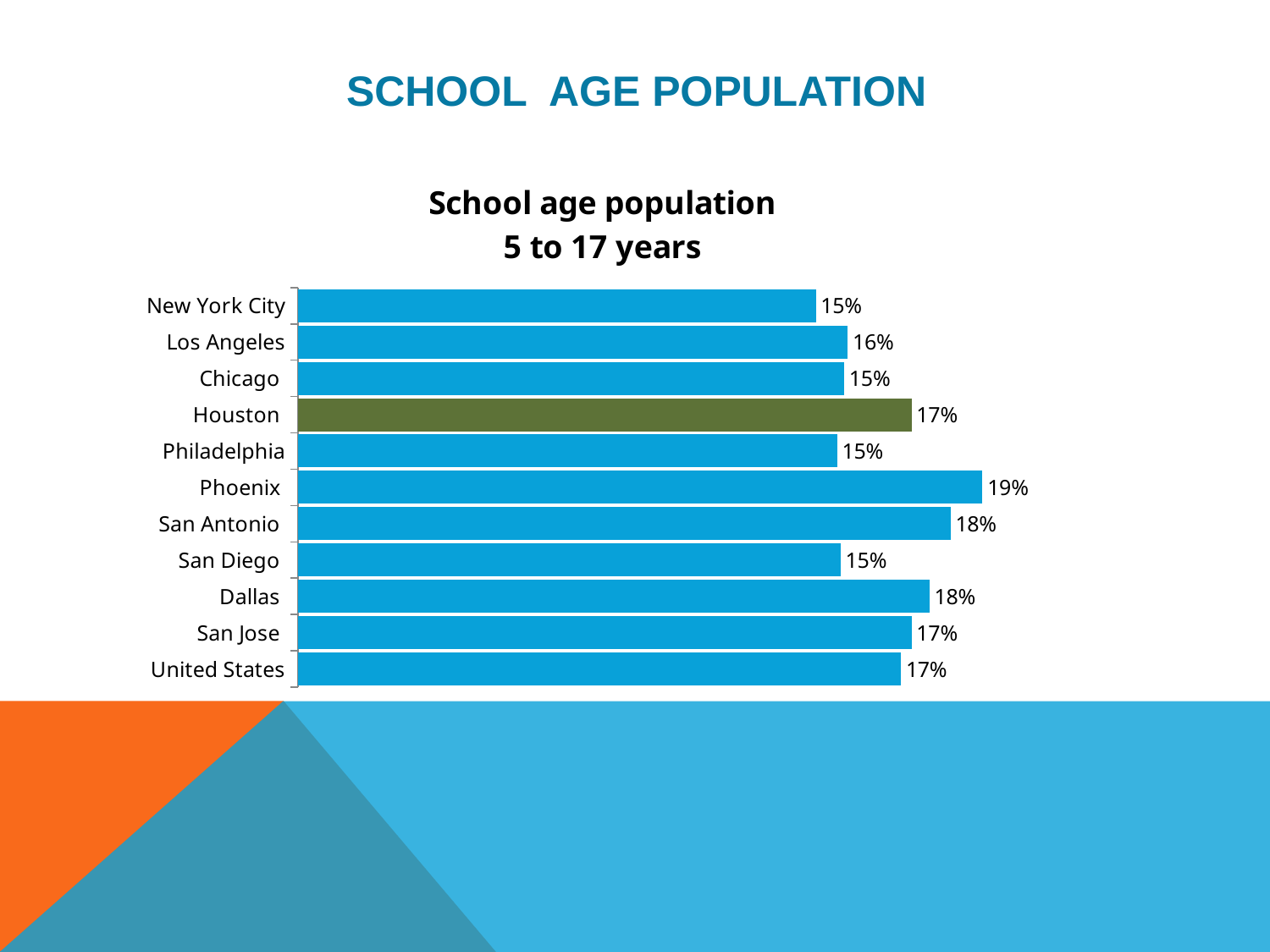
What is the value shown for Los Angeles? 16% Which is larger, the value for Dallas or the value for San Diego? Dallas How many categories are plotted in the chart? 11 What kind of chart is shown on the slide? Bar chart What is the value shown for the United States? 17% Which is larger, the value for Phoenix or the value for Houston? Phoenix What is the difference between the values for San Antonio and Los Angeles? 2 percentage points What is the difference between the values for Phoenix and New York City? 4 percentage points What is the value shown for Phoenix? 19% Which category has the highest school age population percentage? Phoenix What is the school age population percentage for Houston? 17% Which category's bar is coloured green instead of blue? Houston